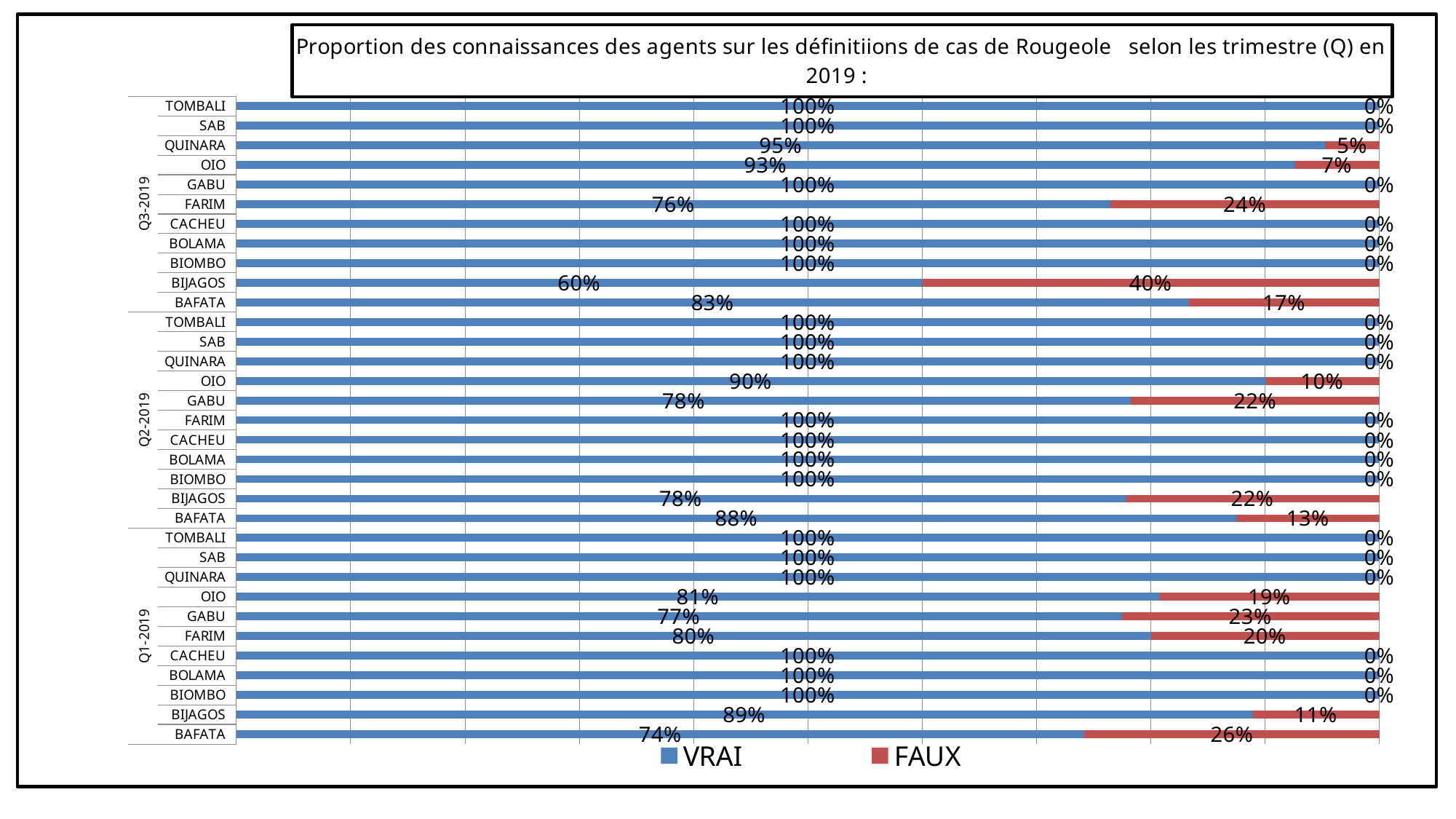
What is the VRAI value for OIO in Q2-2019? 90% What is the FAUX value for BAFATA in Q1-2019? 26% What is the total of the stacked bar for BIJAGOS in Q2-2019? 100% Which region has the lowest VRAI value in Q1-2019? BAFATA (74%) What is the FAUX value for QUINARA in Q3-2019? 5% In Q1-2019, which is larger: the FAUX value for GABU or the FAUX value for OIO? GABU (23%) How many series does the legend list? 2 Which region and quarter has the highest FAUX value on the chart? BIJAGOS, Q3-2019 (40%) What kind of chart is shown on the slide? Stacked horizontal bar chart In Q3-2019, what is the difference between the VRAI and FAUX values for FARIM? 52 percentage points How many regions are listed within each quarter group? 11 What is the VRAI value for BIJAGOS in Q3-2019? 60%